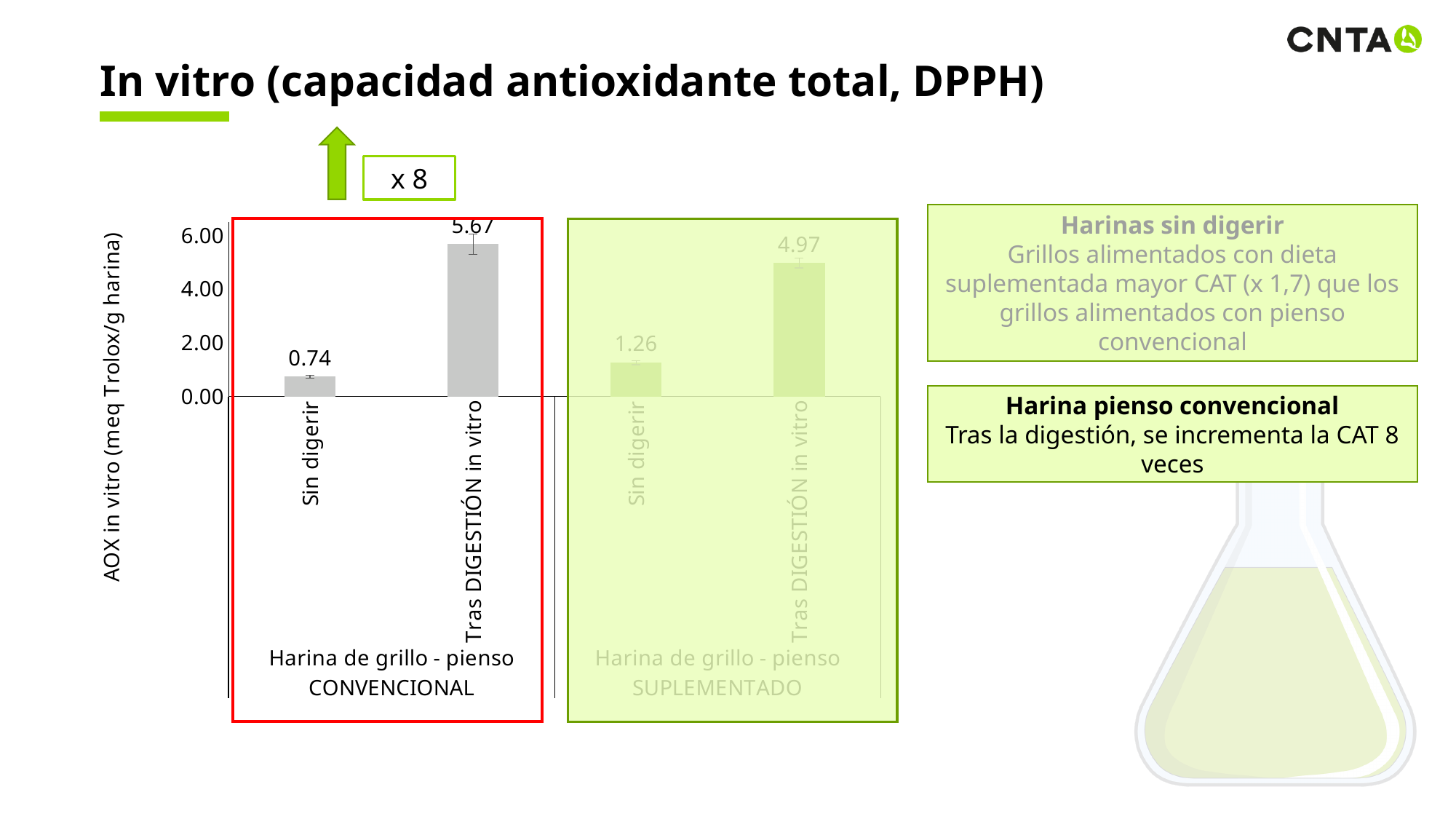
What is the label of the vertical axis of the chart? AOX in vitro (meq Trolox/g harina) What is the difference between the 'Sin digerir' values of the SUPLEMENTADO and CONVENCIONAL groups? 0.52 What is the difference between the 'Tras DIGESTIÓN in vitro' and 'Sin digerir' values in the CONVENCIONAL group? 4.93 What is the value for 'Tras DIGESTIÓN in vitro' in the 'Harina de grillo - pienso SUPLEMENTADO' group? 4.97 Which bar has the highest value in the chart? Tras DIGESTIÓN in vitro (CONVENCIONAL) Which is larger: 'Tras DIGESTIÓN in vitro' for CONVENCIONAL or 'Tras DIGESTIÓN in vitro' for SUPLEMENTADO? CONVENCIONAL What is the value for 'Tras DIGESTIÓN in vitro' in the 'Harina de grillo - pienso CONVENCIONAL' group? 5.67 What is the value for 'Sin digerir' in the 'Harina de grillo - pienso CONVENCIONAL' group? 0.74 Which bar has the lowest value in the chart? Sin digerir (CONVENCIONAL) What kind of chart is shown on the slide? bar chart What is the value for 'Sin digerir' in the 'Harina de grillo - pienso SUPLEMENTADO' group? 1.26 How many bars are plotted in the chart? 4